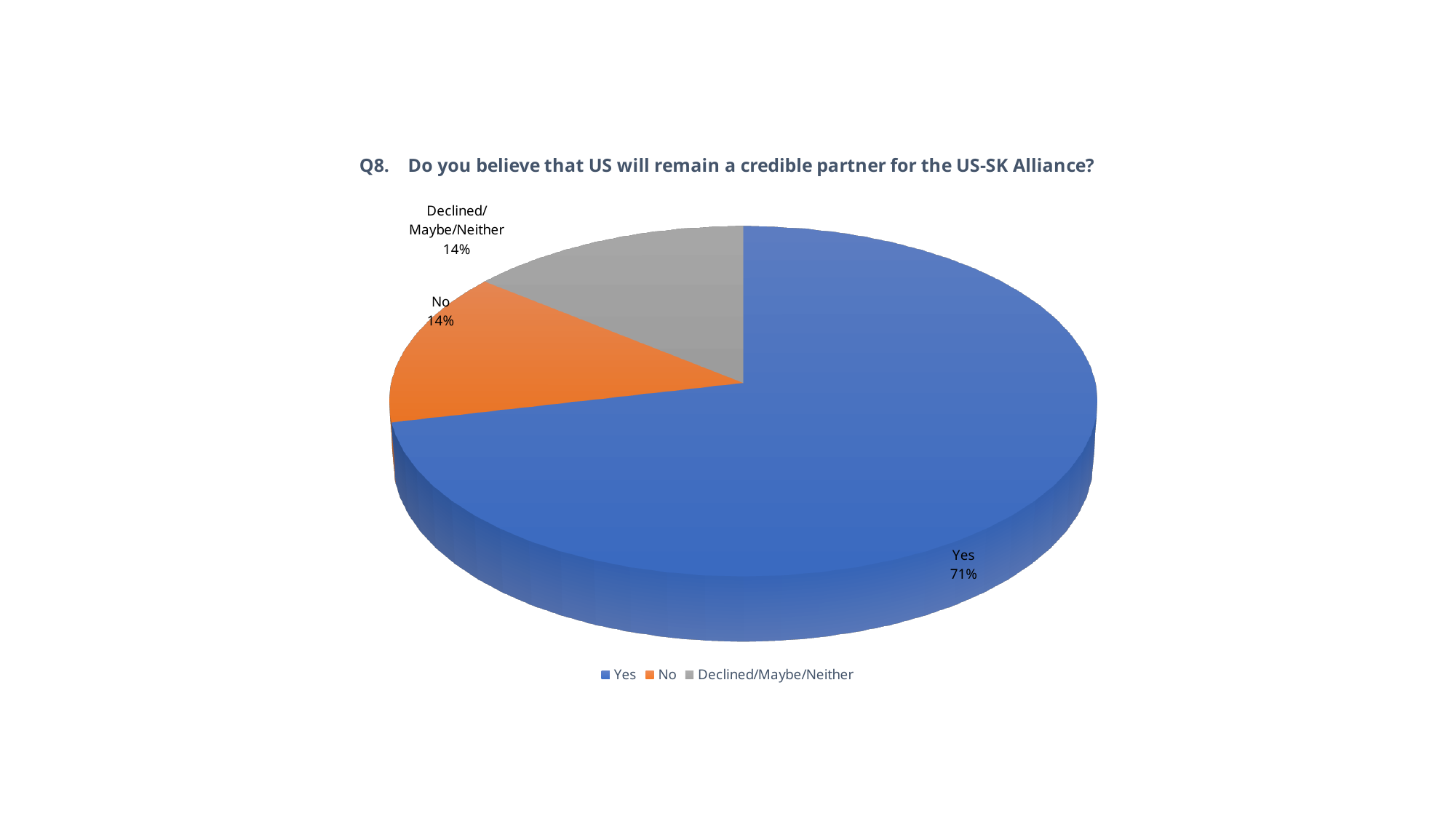
Which is larger, the share for "Yes" or the share for "Declined/Maybe/Neither"? Yes What colour is the "No" slice? Orange Which response has the largest share of the pie? Yes What percentage of respondents answered "Yes"? 71% What percentage is shown for "Declined/Maybe/Neither"? 14% How many entries does the legend list? 3 What type of chart is shown on the slide? Pie chart What percentage of respondents answered "No"? 14% How many slices does the pie chart have? 3 What is the title of the chart? Q8. Do you believe that US will remain a credible partner for the US-SK Alliance? What is the difference in percentage points between "Yes" and "No"? 57